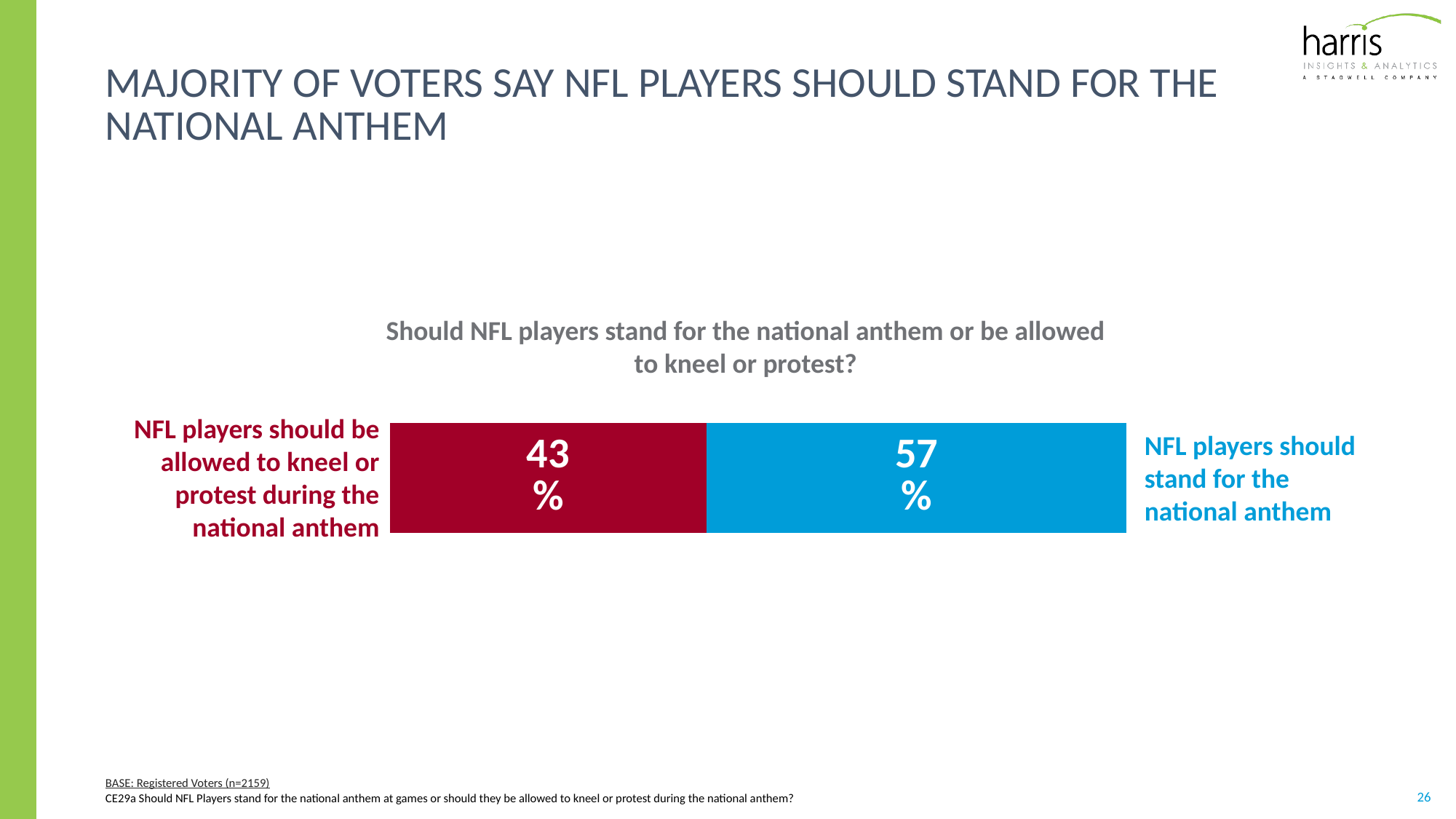
How many response categories are shown in the chart? 2 Is the share saying NFL players should stand for the national anthem larger than the share saying they should be allowed to kneel or protest? Yes What is the difference in percentage points between the share saying players should stand and the share saying players should be allowed to kneel or protest? 14 Which response has the larger share: NFL players should stand for the national anthem, or NFL players should be allowed to kneel or protest? NFL players should stand for the national anthem What kind of chart is shown on the slide? Stacked bar chart What percentage of voters say NFL players should stand for the national anthem? 57% What is the title of the chart? Should NFL players stand for the national anthem or be allowed to kneel or protest? Which response has the smaller share of voters? NFL players should be allowed to kneel or protest during the national anthem What colour is the segment representing voters who say NFL players should stand for the national anthem? Blue What is the total of the two segments in the stacked bar? 100% What percentage of voters say NFL players should be allowed to kneel or protest during the national anthem? 43%